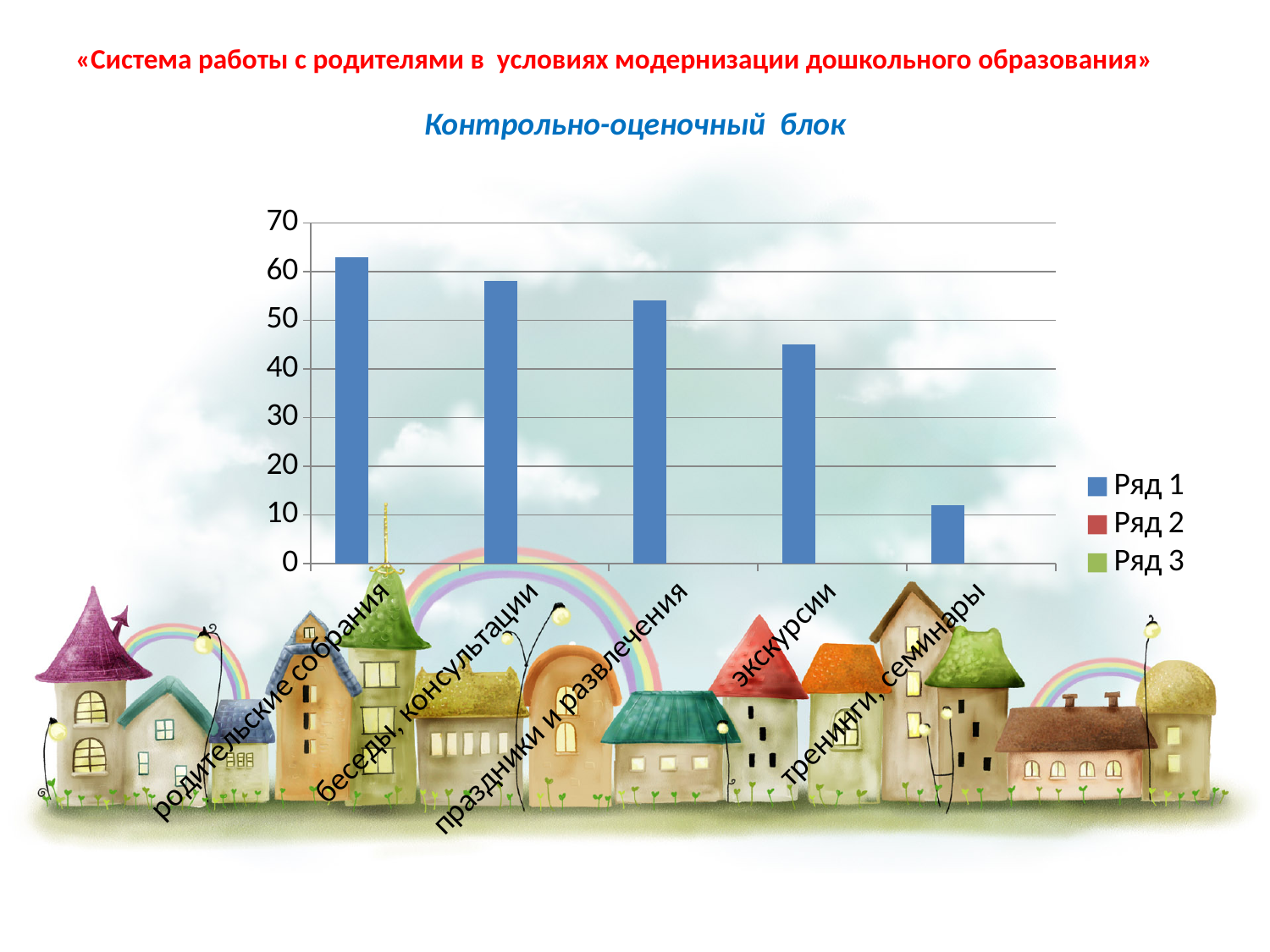
Is the value for родительские собрания greater or less than 50? greater Which is larger, the value for беседы, консультации or the value for экскурсии? беседы, консультации Which category has the highest bar in the chart? родительские собрания How many categories are plotted on the x axis of the chart? 5 What are the three entries listed in the chart's legend? Ряд 1, Ряд 2, Ряд 3 Is the value for тренинги, семинары greater or less than 20? less Do the bar values rise or fall from left to right along the x axis? fall Is the value for праздники и развлечения greater or less than 40? greater Which category has the lowest bar in the chart? тренинги, семинары How many series does the chart's legend list? 3 What kind of chart is shown on the slide? bar chart